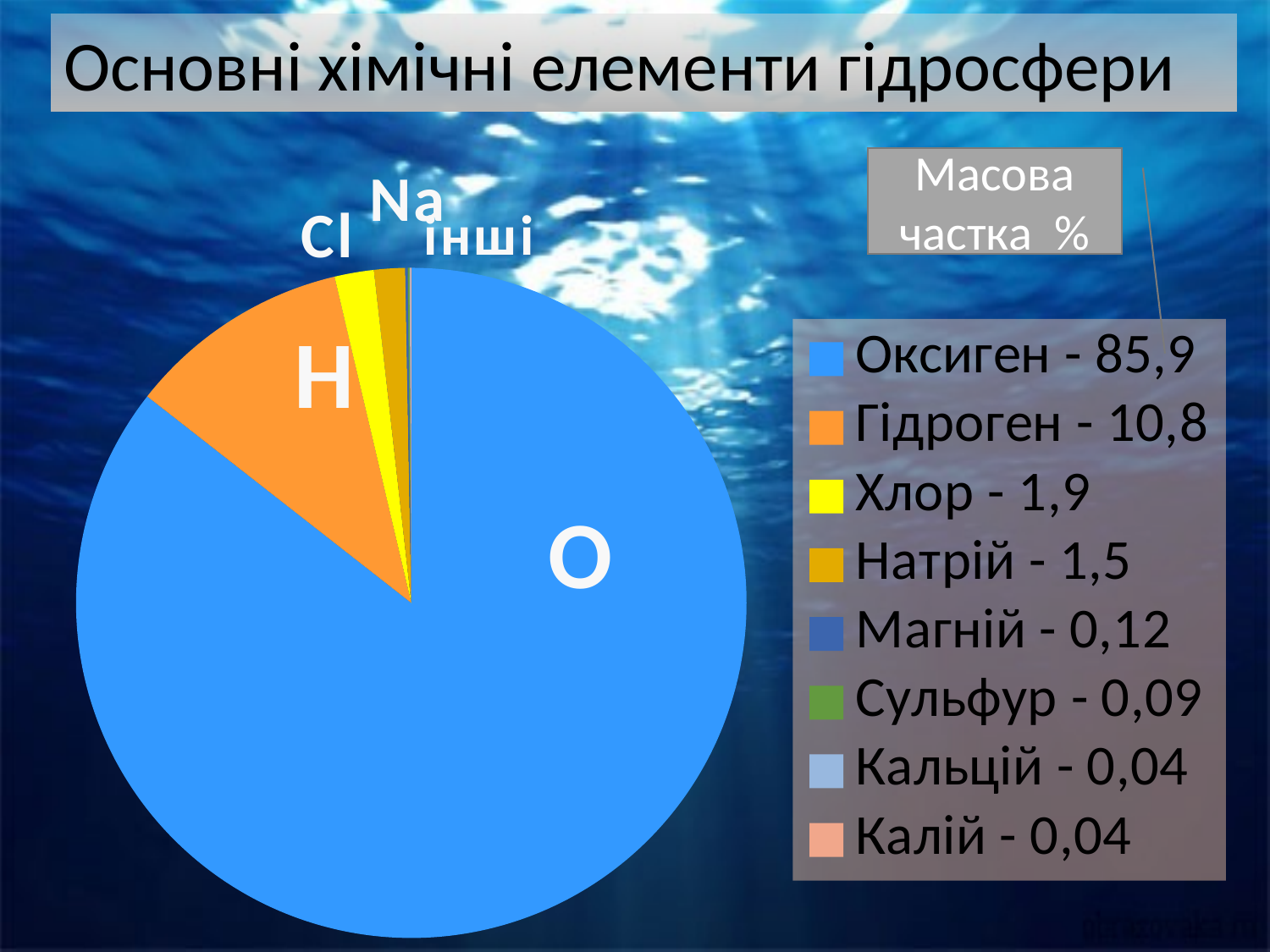
What is the mass fraction (%) of Оксиген according to the legend? 85,9 What is the mass fraction (%) of Натрій according to the legend? 1,5 Which is larger, the value for Хлор or the value for Натрій? Хлор What is the title of the slide? Основні хімічні елементи гідросфери What colour is the slice for Гідроген? orange What is the mass fraction (%) of Хлор according to the legend? 1,9 What is the mass fraction (%) of Гідроген according to the legend? 10,8 What is the mass fraction (%) of Магній according to the legend? 0,12 How many elements are listed in the legend? 8 Which element has the largest share of the pie? Оксиген What kind of chart is shown on the slide? pie chart What is the difference between the values for Оксиген and Гідроген? 75,1